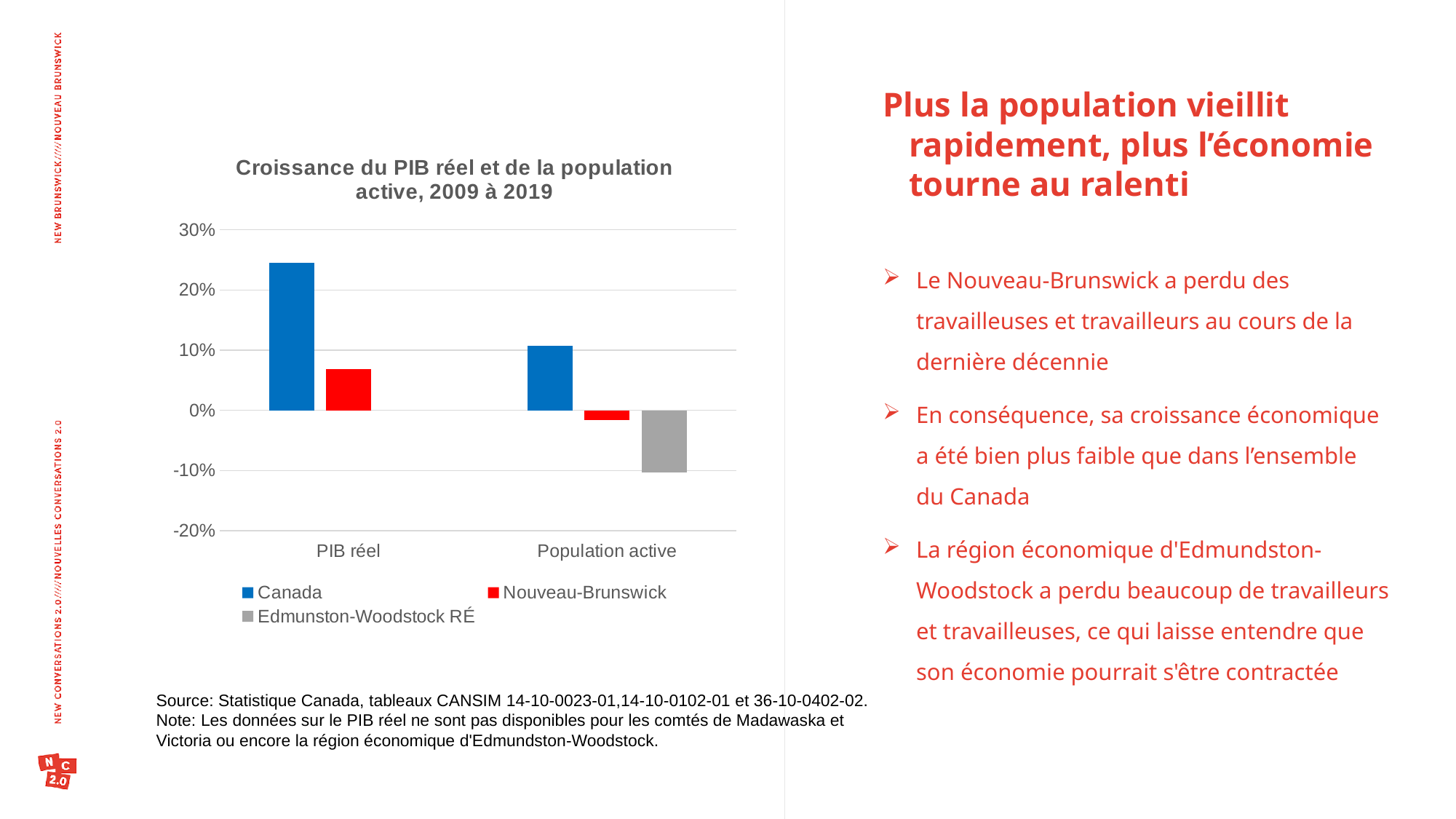
What is the title of the chart? Croissance du PIB réel et de la population active, 2009 à 2019 In the Population active category, which series has the lowest value? Edmunston-Woodstock RÉ In the PIB réel category, which is larger: Canada or Nouveau-Brunswick? Canada Is the value for Nouveau-Brunswick in the Population active category greater or less than 0%? less What kind of chart is shown on the slide? bar chart What colour represents Canada in the chart? blue How many categories are shown on the x axis of the chart? 2 In the Population active category, which series has the highest value? Canada How many series does the chart legend list? 3 Is the value for Canada in the PIB réel category greater or less than 20%? greater Is the value for Nouveau-Brunswick in the PIB réel category greater or less than 10%? less